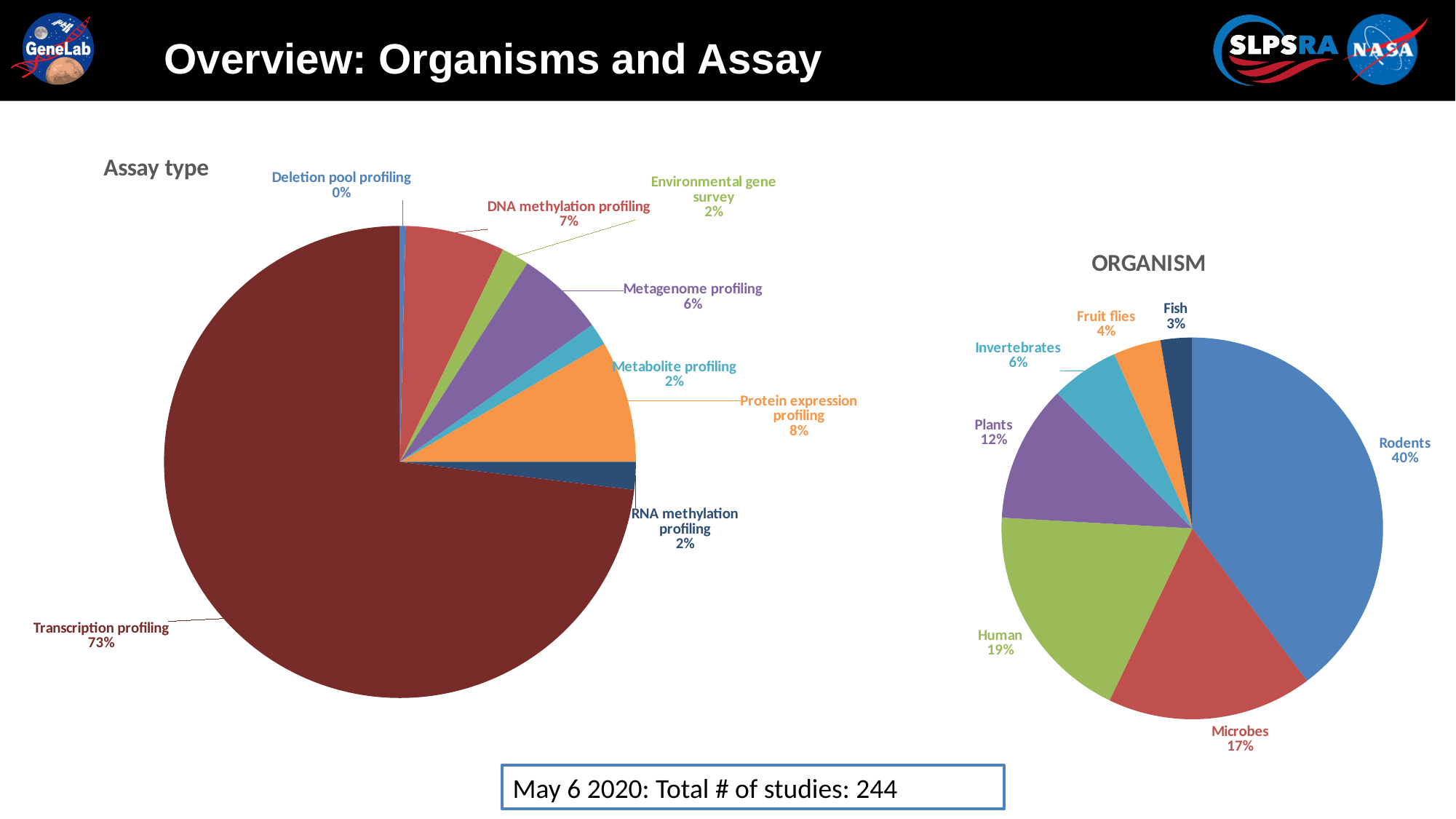
What is the title of the chart on the right side of the slide? ORGANISM What kind of chart is the ORGANISM chart? Pie chart In the ORGANISM chart, what is the difference in percentage points between Human and Microbes? 2% How many organism categories are shown in the ORGANISM chart? 7 In the Assay type chart, what share does Transcription profiling have? 73% How many assay type categories are labelled in the Assay type chart? 8 In the Assay type chart, which is larger, Metagenome profiling or Metabolite profiling? Metagenome profiling In the Assay type chart, which assay type has the largest slice? Transcription profiling In the ORGANISM chart, which organism has the smallest slice? Fish In the Assay type chart, what percentage is shown for Protein expression profiling? 8% In the Assay type chart, what is the difference in percentage points between DNA methylation profiling and Metagenome profiling? 1% In the ORGANISM chart, what share do Rodents have? 40%